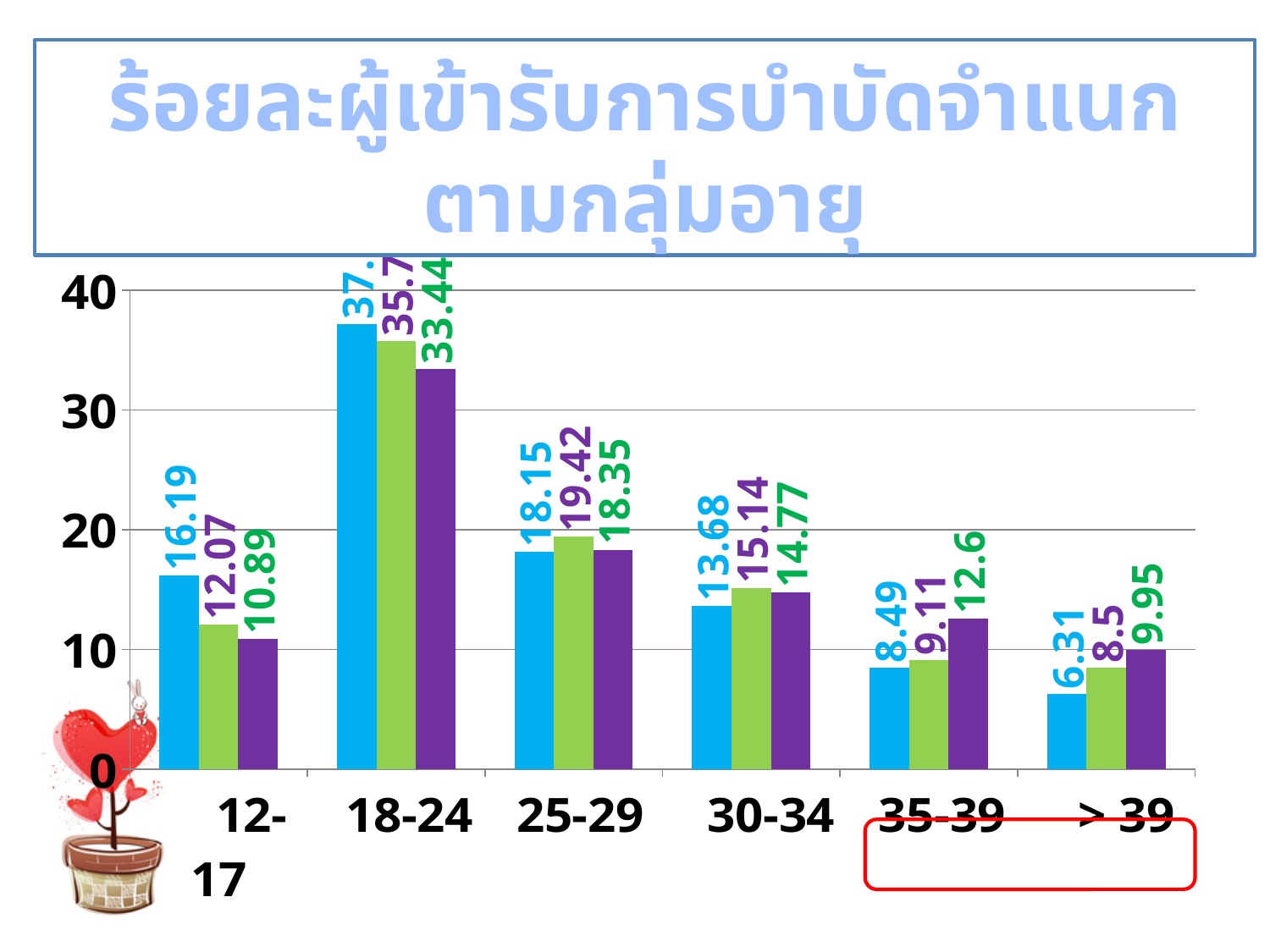
What is the value of the purple bar for the 35-39 age group? 12.6 Which age group has the highest values across all three bars? 18-24 For the 35-39 age group, which is larger: the blue bar or the purple bar? the purple bar Which age group has the lowest blue bar? > 39 What is the value of the blue bar for the > 39 age group? 6.31 How many age groups are shown on the x axis? 6 Is the value of the green bar for the 18-24 age group greater or less than 30? greater What is the value of the blue bar for the 12-17 age group? 16.19 From the 18-24 age group to the > 39 age group, do the blue bar values rise or fall? fall What is the value of the green bar for the 25-29 age group? 19.42 What kind of chart is shown on the slide? bar chart What is the difference between the blue and green bars for the 12-17 age group? 4.12